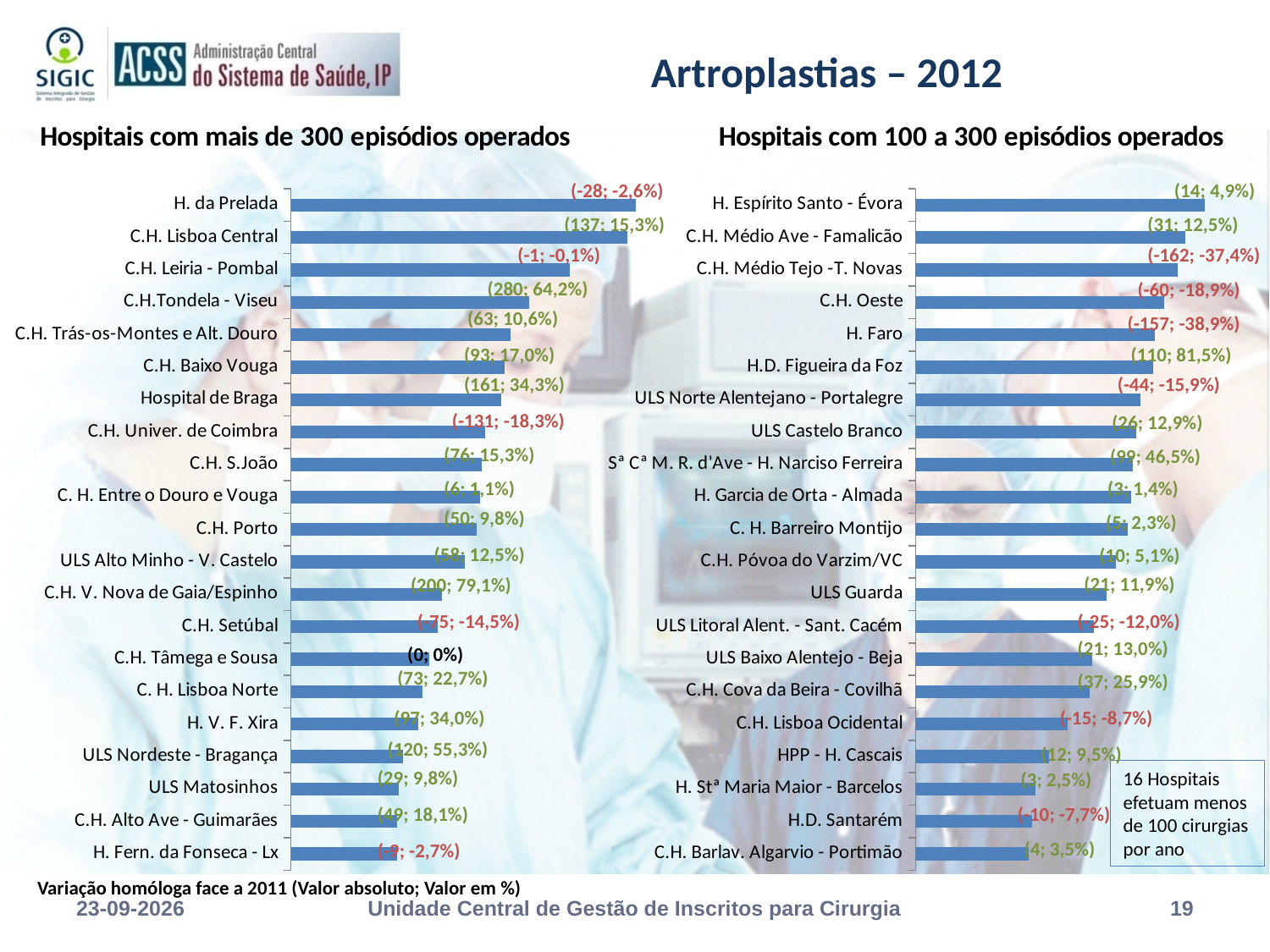
On the right chart, 'Hospitais com 100 a 300 episódios operados', which bar is longer: C.H. Oeste or ULS Guarda? C.H. Oeste On the right chart, 'Hospitais com 100 a 300 episódios operados', which hospital has the shortest bar? C.H. Barlav. Algarvio - Portimão On the left chart, 'Hospitais com mais de 300 episódios operados', which hospital has the longest bar? H. da Prelada How many hospitals are listed on the left chart, 'Hospitais com mais de 300 episódios operados'? 21 On the left chart, 'Hospitais com mais de 300 episódios operados', what is the variation label shown for C.H. Univer. de Coimbra? (-131; -18,3%) According to the note on the slide, how many hospitals perform fewer than 100 surgeries per year? 16 Hospitais On the right chart, 'Hospitais com 100 a 300 episódios operados', which hospital has the longest bar? H. Espírito Santo - Évora On the left chart, 'Hospitais com mais de 300 episódios operados', what is the variation label shown for C.H. Tâmega e Sousa? (0; 0%) On the right chart, 'Hospitais com 100 a 300 episódios operados', what is the variation label shown for H. Faro? (-157; -38,9%) What type of chart is used on the left chart, 'Hospitais com mais de 300 episódios operados'? bar chart On the right chart, 'Hospitais com 100 a 300 episódios operados', what is the variation label shown for H.D. Figueira da Foz? (110; 81,5%) On the left chart, 'Hospitais com mais de 300 episódios operados', what is the variation label shown for C.H.Tondela - Viseu? (280; 64,2%)